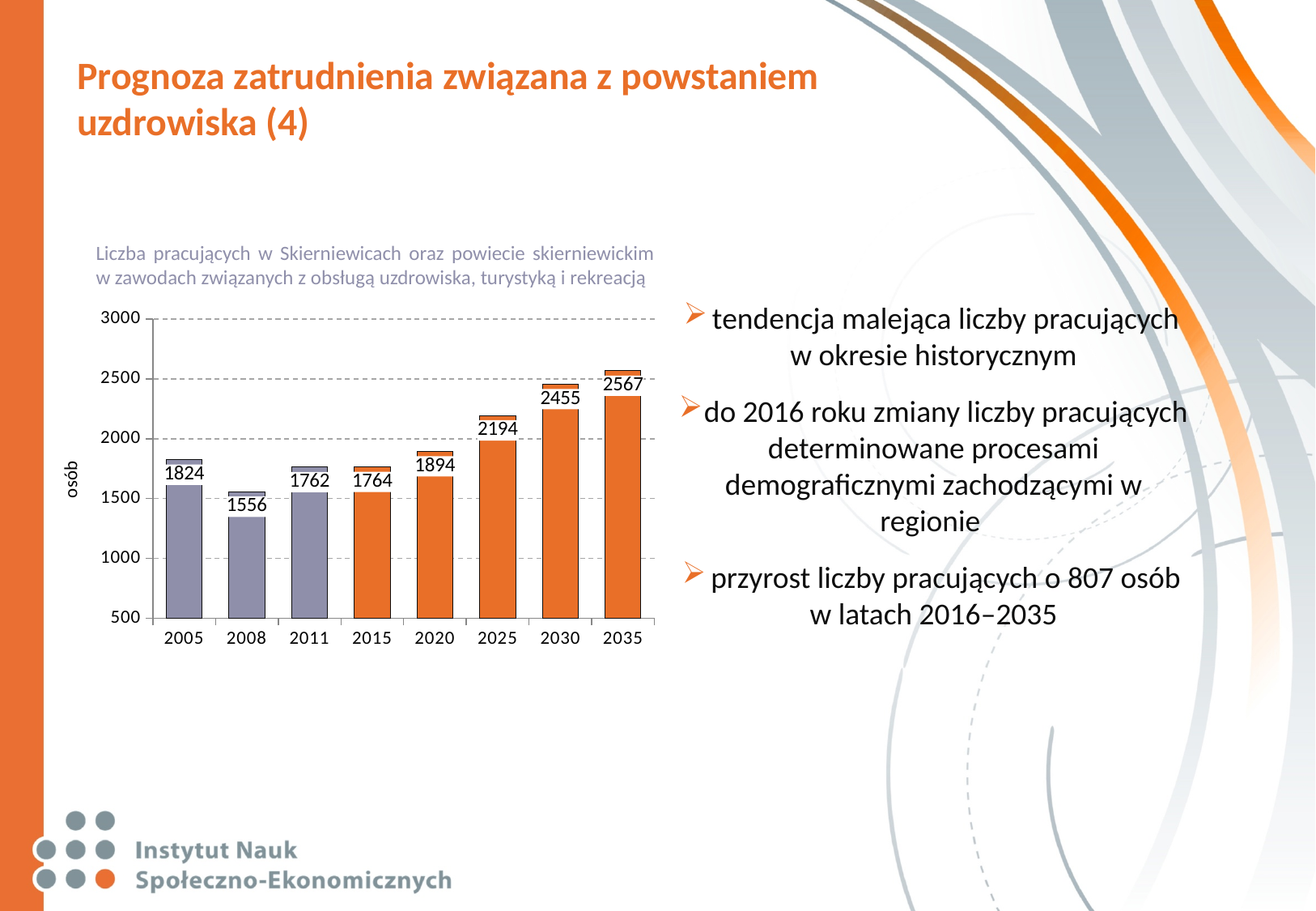
What is the value for 2005? 1824 How many years are shown on the x axis? 8 Which is larger, the value for 2020 or the value for 2011? 2020 What is the difference between the values for 2005 and 2008? 268 What is the value for 2035? 2567 What is the label of the vertical axis? osób What is the difference between the values for 2035 and 2030? 112 Which year has the lowest value? 2008 What is the value for 2025? 2194 Is the value for 2030 greater or less than 2000? greater What kind of chart is shown on the slide? bar chart Which year has the highest value? 2035